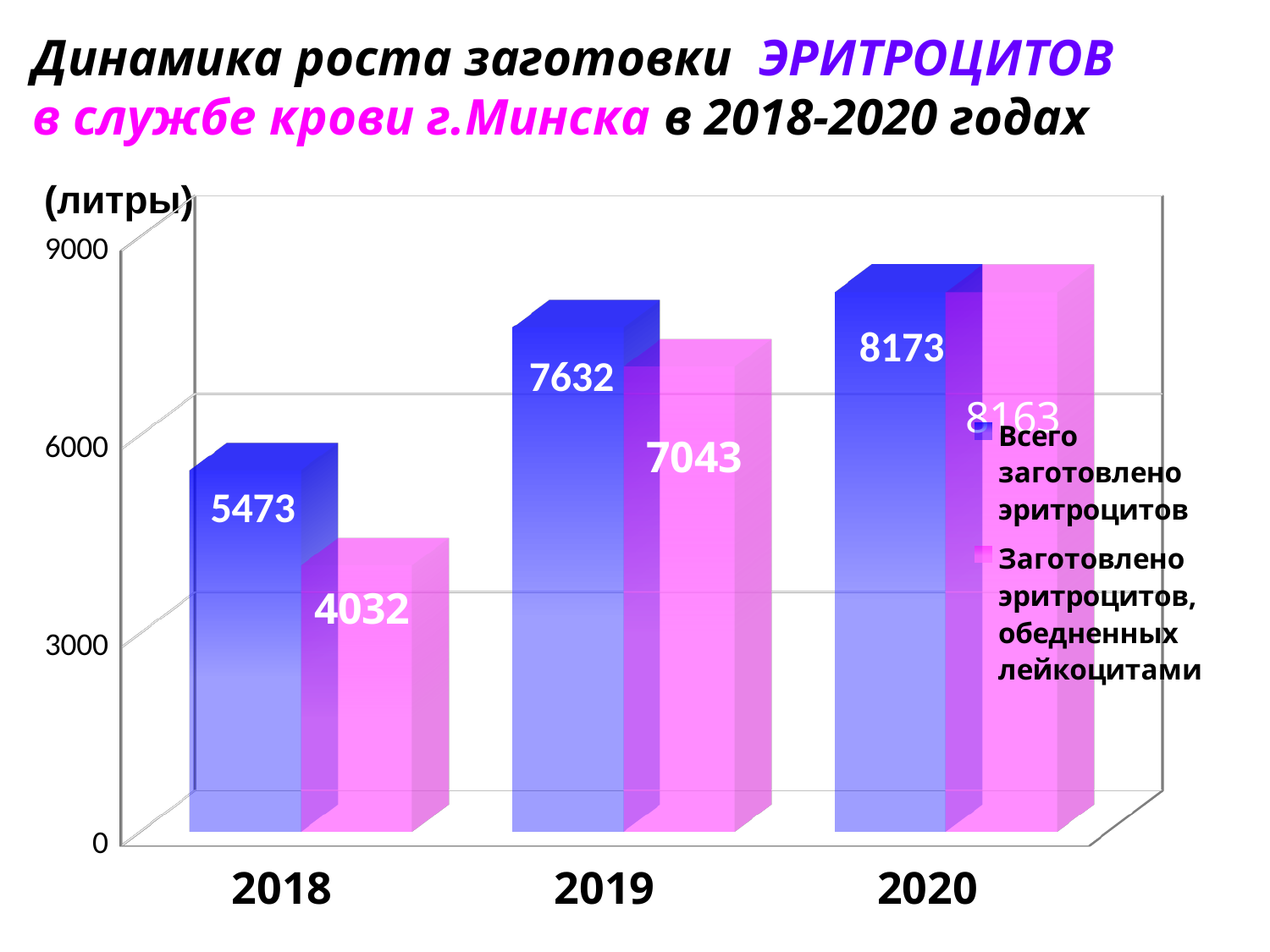
In which year was the volume of leukocyte-depleted red blood cells procured the lowest? 2018 Which was larger in 2019: the total red blood cells procured or the leukocyte-depleted red blood cells procured? Total red blood cells procured (7632) What was the total volume of red blood cells procured (Всего заготовлено эритроцитов) in 2018? 5473 What was the volume of leukocyte-depleted red blood cells procured in 2018? 4032 What is the difference between the total red blood cells procured and the leukocyte-depleted red blood cells procured in 2018? 1441 By how much did the total volume of red blood cells procured increase from 2018 to 2019? 2159 In which year was the total volume of red blood cells procured the highest? 2020 What was the total volume of red blood cells procured (Всего заготовлено эритроцитов) in 2020? 8173 How many series does the chart legend list? 2 What was the volume of leukocyte-depleted red blood cells (Заготовлено эритроцитов, обедненных лейкоцитами) procured in 2019? 7043 What kind of chart is shown on the slide? Bar chart How many years are shown on the x axis of the chart? 3